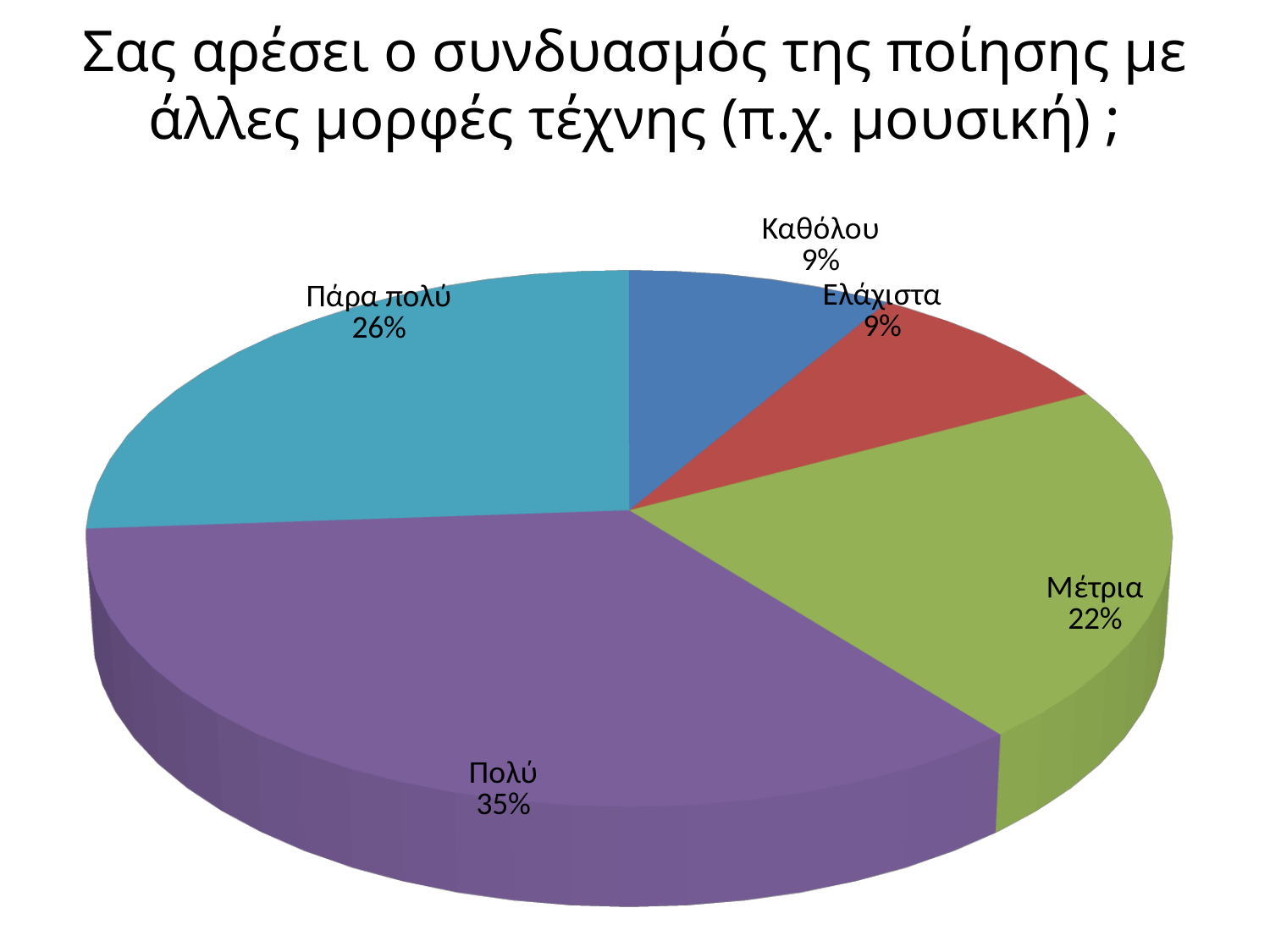
What is the difference in percentage points between "Μέτρια" and "Καθόλου"? 13 Which category has the largest slice of the pie? Πολύ What is the difference in percentage points between "Πολύ" and "Πάρα πολύ"? 9 What is the value shown for "Ελάχιστα"? 9% What kind of chart is shown on the slide? Pie chart What is the value shown for "Καθόλου"? 9% What is the value shown for "Πάρα πολύ"? 26% Which is larger, the slice for "Πάρα πολύ" or the slice for "Μέτρια"? Πάρα πολύ What is the value shown for "Μέτρια"? 22% What colour is the "Πολύ" slice? Purple How many categories (slices) does the pie chart have? 5 What share of the pie does the "Πολύ" slice represent? 35%